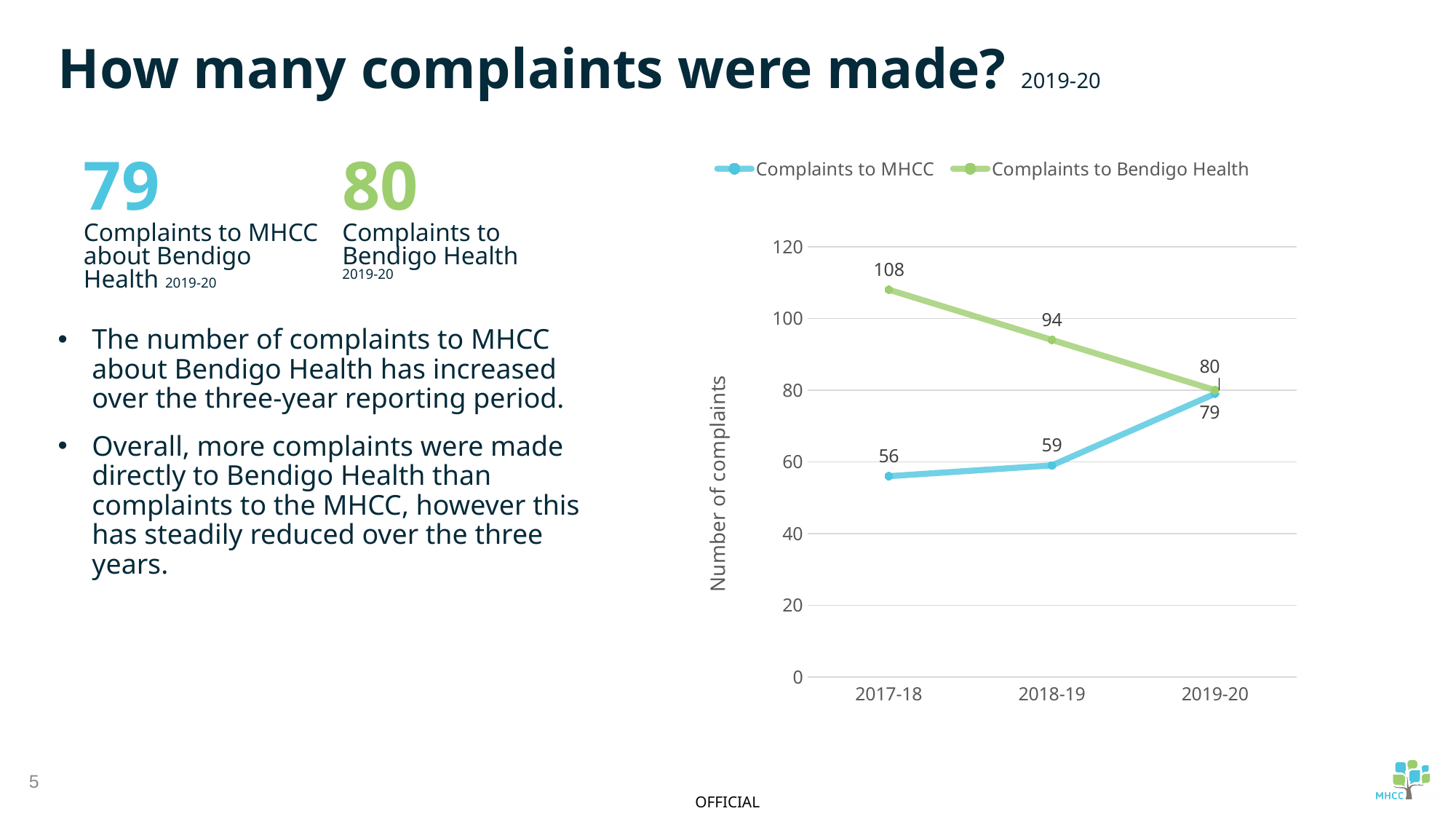
Which series has the larger value in 2018-19, Complaints to MHCC or Complaints to Bendigo Health? Complaints to Bendigo Health What is the difference between Complaints to Bendigo Health and Complaints to MHCC in 2017-18? 52 What kind of chart is shown on the slide? line chart How many points are plotted along the x axis for each series? 3 What is the value for Complaints to MHCC in 2017-18? 56 Do the values for Complaints to Bendigo Health rise or fall from 2017-18 to 2019-20? fall What is the label on the vertical axis of the chart? Number of complaints What is the value for Complaints to Bendigo Health in 2018-19? 94 In which year were Complaints to Bendigo Health highest? 2017-18 What is the value for Complaints to Bendigo Health in 2019-20? 80 In which year were Complaints to MHCC lowest? 2017-18 How many series does the chart legend list? 2